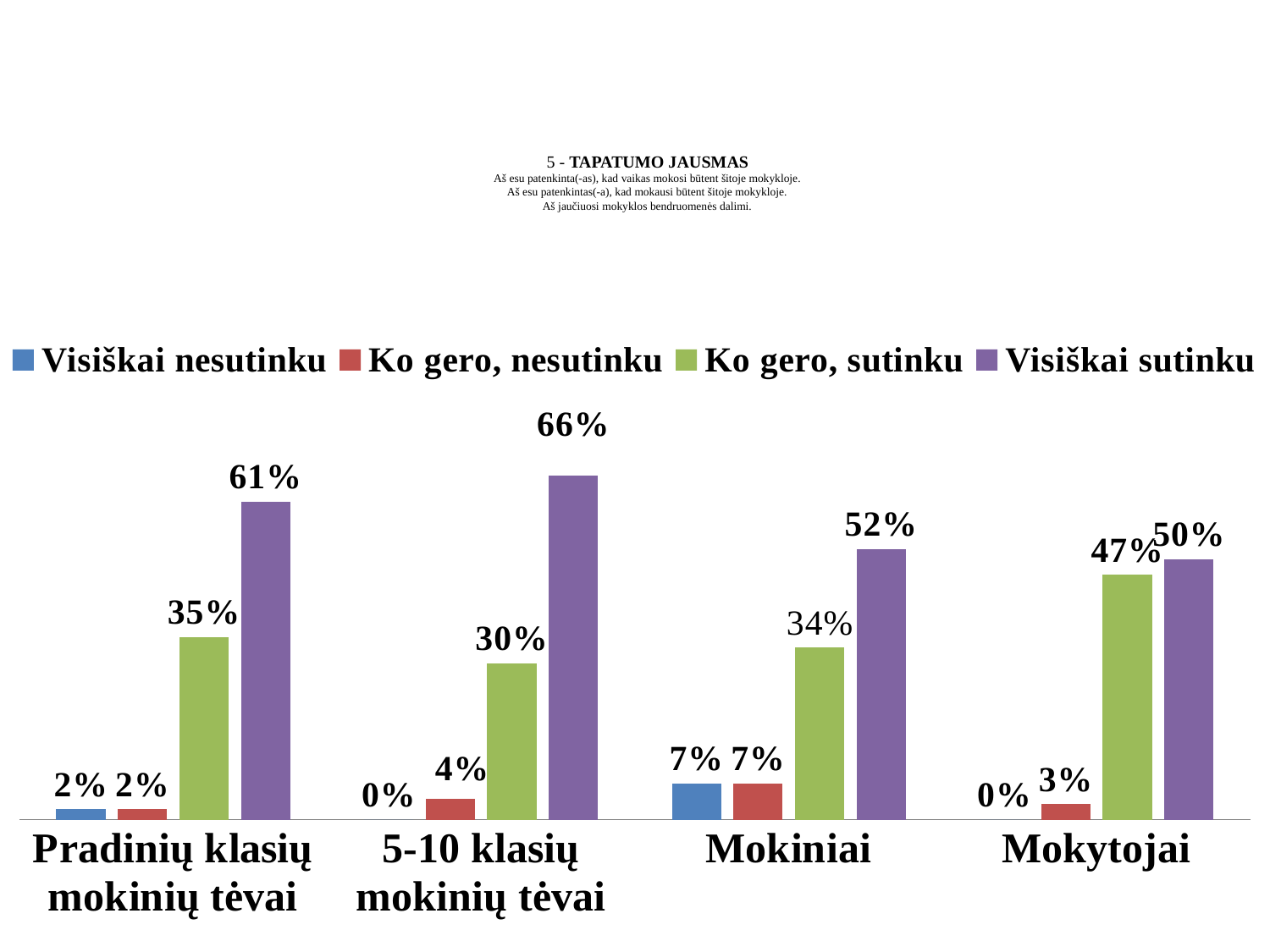
Which category has the lowest value for "Ko gero, sutinku"? 5-10 klasių mokinių tėvai What is the value for "Visiškai sutinku" in the "5-10 klasių mokinių tėvai" category? 66% Which is larger: "Ko gero, sutinku" for "Mokytojai" or "Ko gero, sutinku" for "Mokiniai"? Mokytojai How many series does the legend list? 4 What is the difference between the "Visiškai sutinku" values for "Pradinių klasių mokinių tėvai" and "Mokiniai"? 9% What is the value for "Ko gero, nesutinku" in the "Pradinių klasių mokinių tėvai" category? 2% What is the value for "Ko gero, sutinku" in the "Mokytojai" category? 47% Which category has the highest value for "Visiškai sutinku"? 5-10 klasių mokinių tėvai What is the title of the chart? 5 - TAPATUMO JAUSMAS How many categories are shown on the x axis? 4 What is the value for "Visiškai nesutinku" in the "Mokiniai" category? 7% What kind of chart is shown on the slide? Bar chart